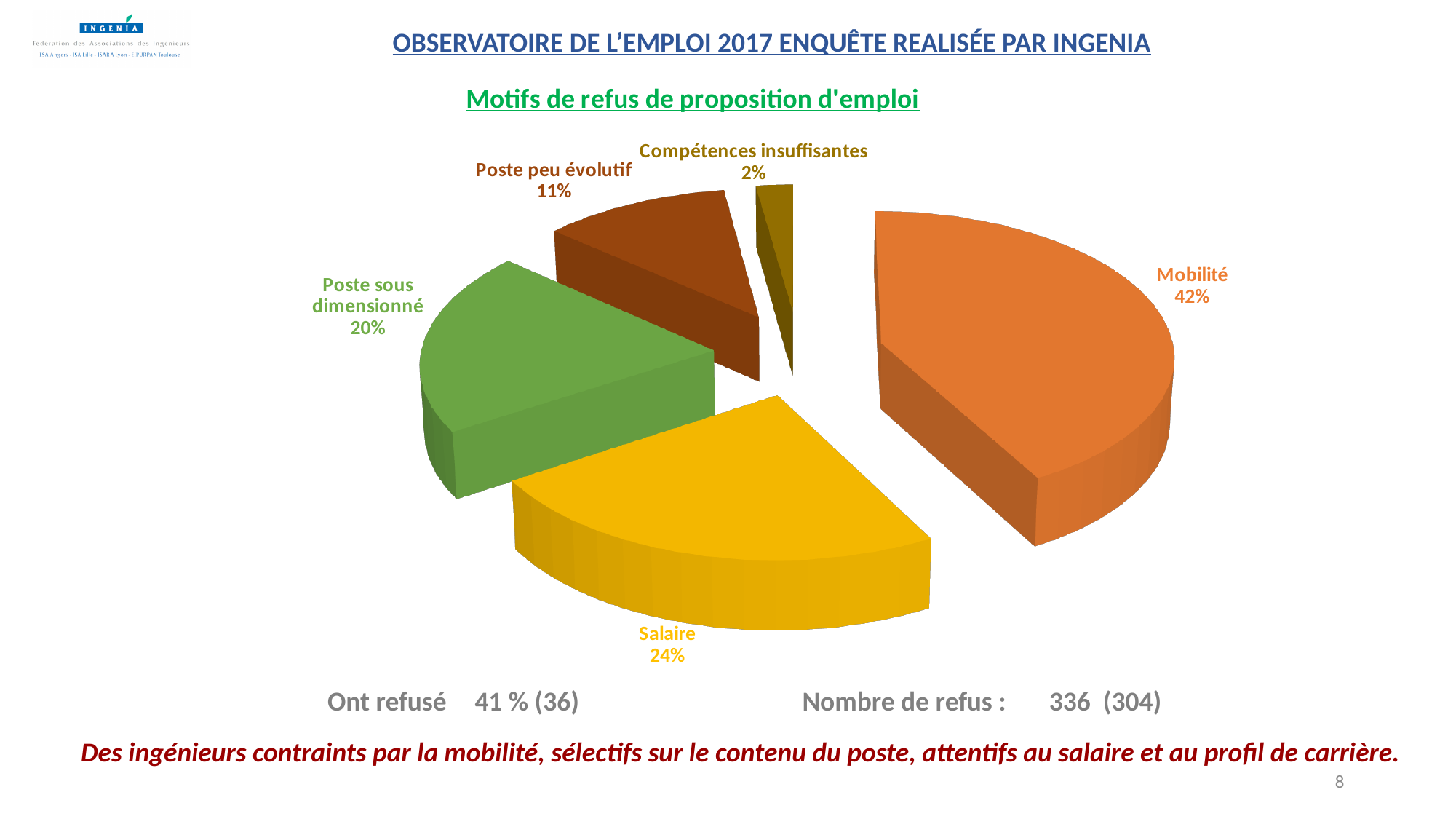
What is the value shown for Salaire? 24% What is the title of the chart? Motifs de refus de proposition d'emploi What colour is the Salaire slice? Yellow Which category has the smallest slice of the pie? Compétences insuffisantes Which is larger, Poste sous dimensionné or Poste peu évolutif? Poste sous dimensionné What share of the pie does Mobilité represent? 42% What is the difference in percentage points between Mobilité and Salaire? 18 How many categories are shown in the pie chart? 5 Which category has the largest slice of the pie? Mobilité What is the value shown for Poste sous dimensionné? 20% What kind of chart is shown on the slide? Pie chart What is the value shown for Poste peu évolutif? 11%